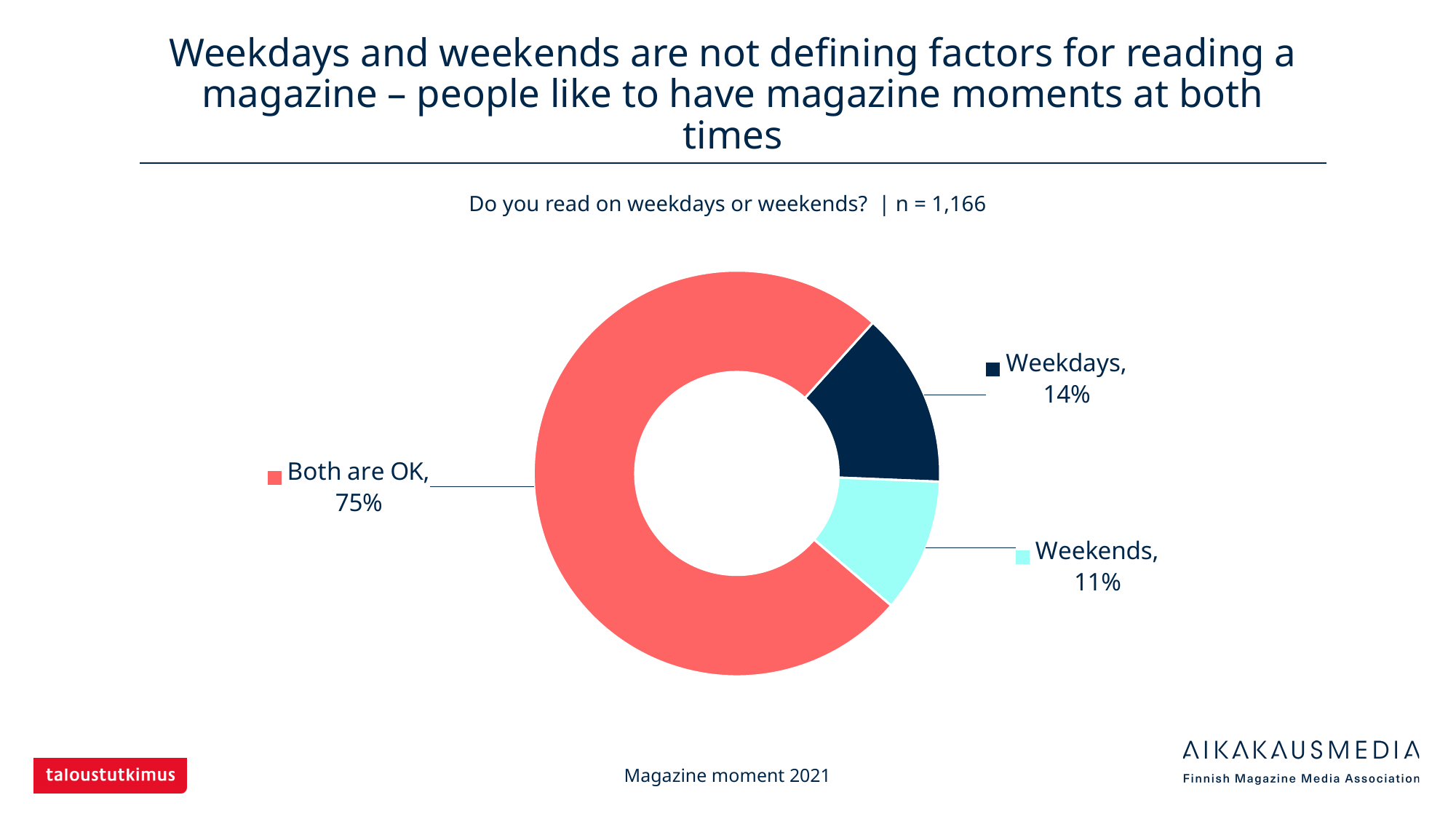
How many response categories are shown in the chart? 3 What percentage of respondents answered "Weekdays"? 14% Which is larger, the share for "Weekdays" or the share for "Weekends"? Weekdays What is the difference in percentage points between "Both are OK" and "Weekdays"? 61 Which response has the smallest share of the chart? Weekends What percentage of respondents answered "Both are OK"? 75% What is the sample size (n) stated for the survey question? 1,166 What colour is the "Both are OK" segment of the chart? Red Which response has the largest share of the chart? Both are OK What percentage of respondents answered "Weekends"? 11% What is the difference in percentage points between "Weekdays" and "Weekends"? 3 What kind of chart is shown on the slide? Doughnut (pie) chart